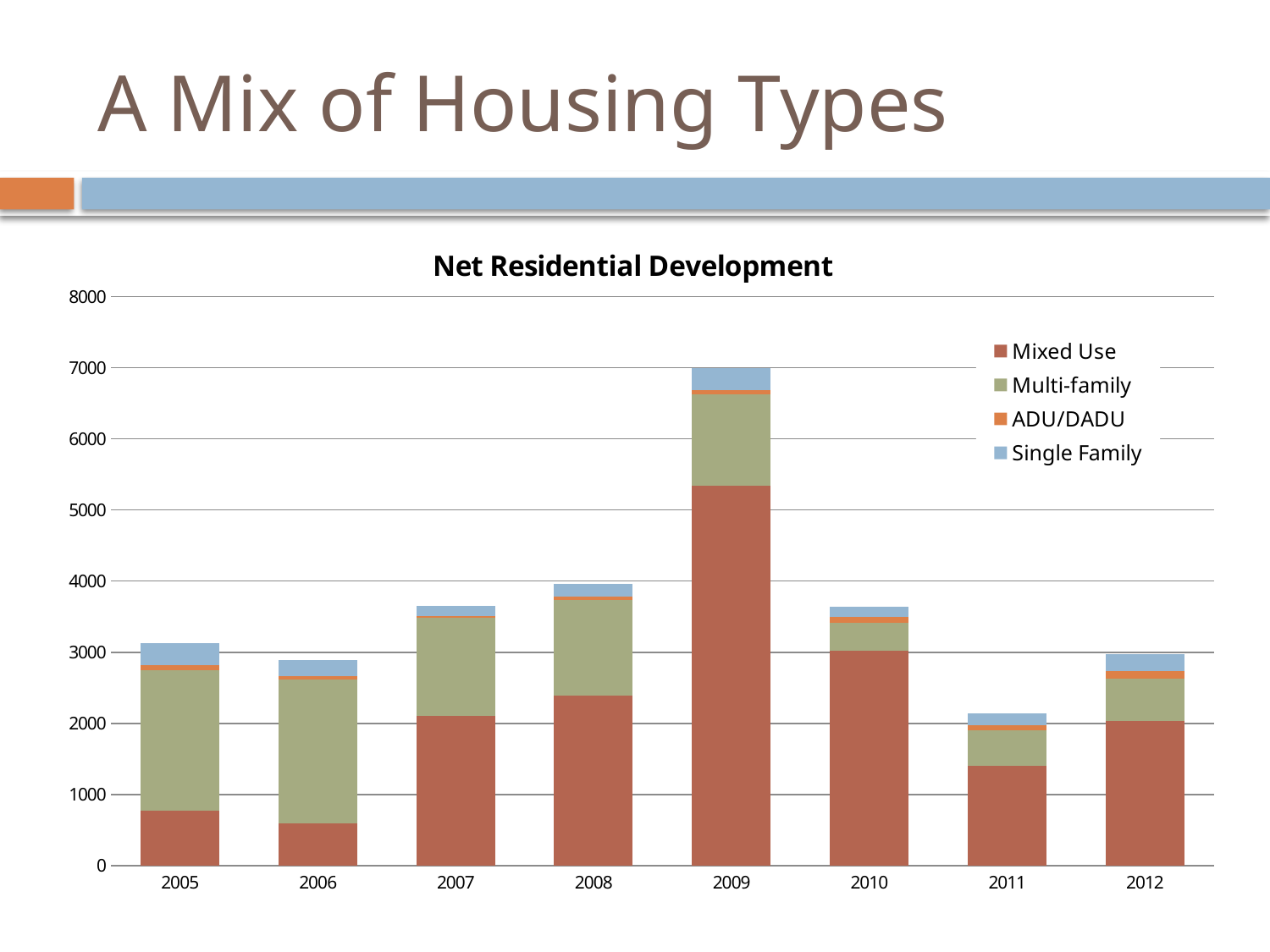
Is the Mixed Use value for 2009 greater or less than 5000? greater Is the total for 2011 greater or less than 3000? less Is the Mixed Use value for 2005 greater or less than 1000? less Which year has the lowest total net residential development? 2011 What is the title of the chart? Net Residential Development Which year has a larger total, 2006 or 2011? 2006 What kind of chart is shown on the slide? Stacked bar chart Which year has the highest total net residential development? 2009 How many years are shown on the x axis? 8 How many series does the legend list? 4 Do the total values rise or fall from 2009 to 2011? fall